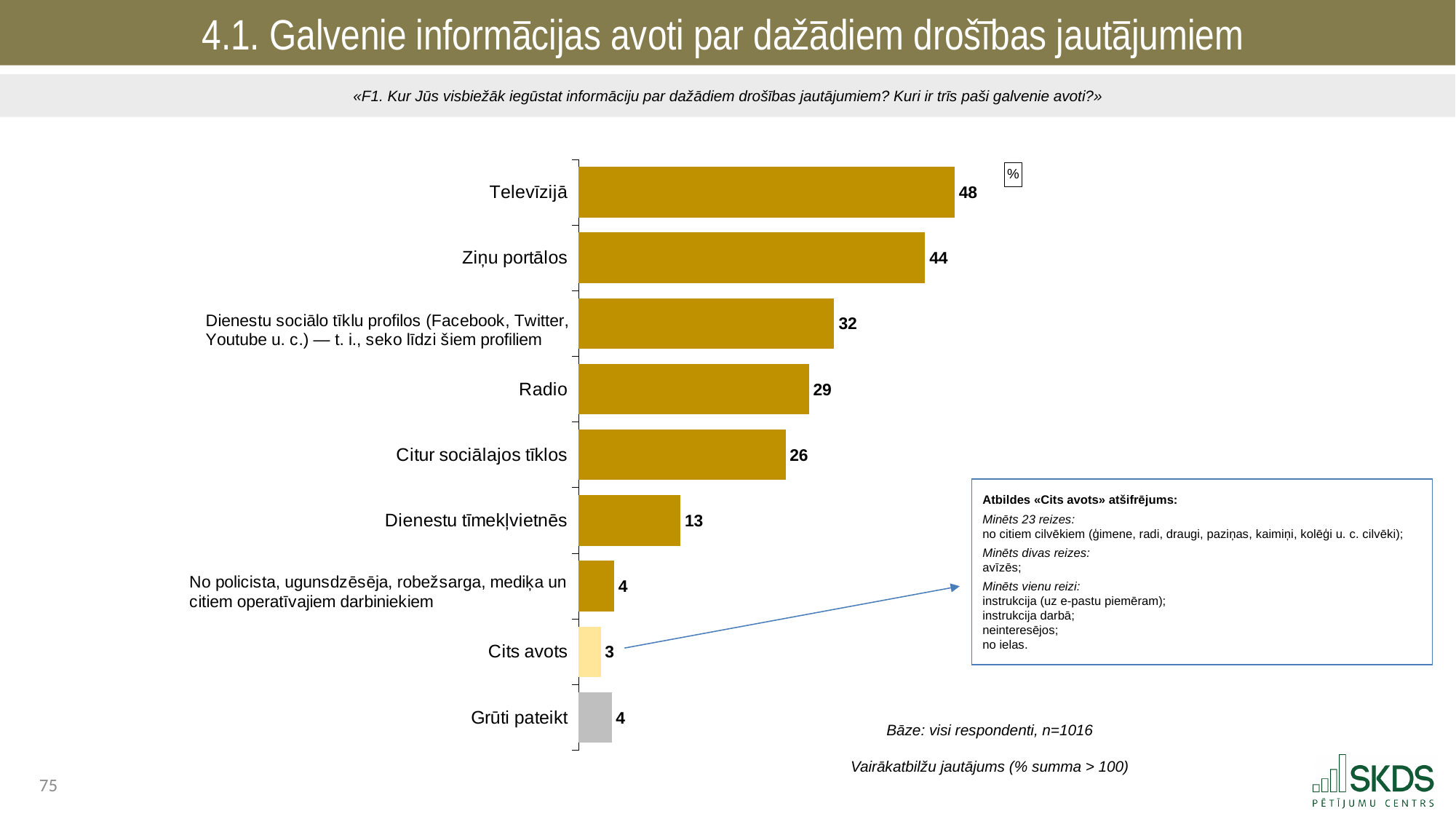
Which category has the lowest value? Cits avots What is the value for Radio? 29 What is the value for Televīzijā? 48 What kind of chart is shown on the slide? Bar chart Which category has the highest value? Televīzijā What is the base (number of respondents) stated on the slide? n=1016 Which is larger, the value for Radio or the value for Citur sociālajos tīklos? Radio What is the difference between the values for Televīzijā and Ziņu portālos? 4 What is the value for Dienestu tīmekļvietnēs? 13 What is the value for Cits avots? 3 How many categories are shown in the chart? 9 What is the value for Ziņu portālos? 44